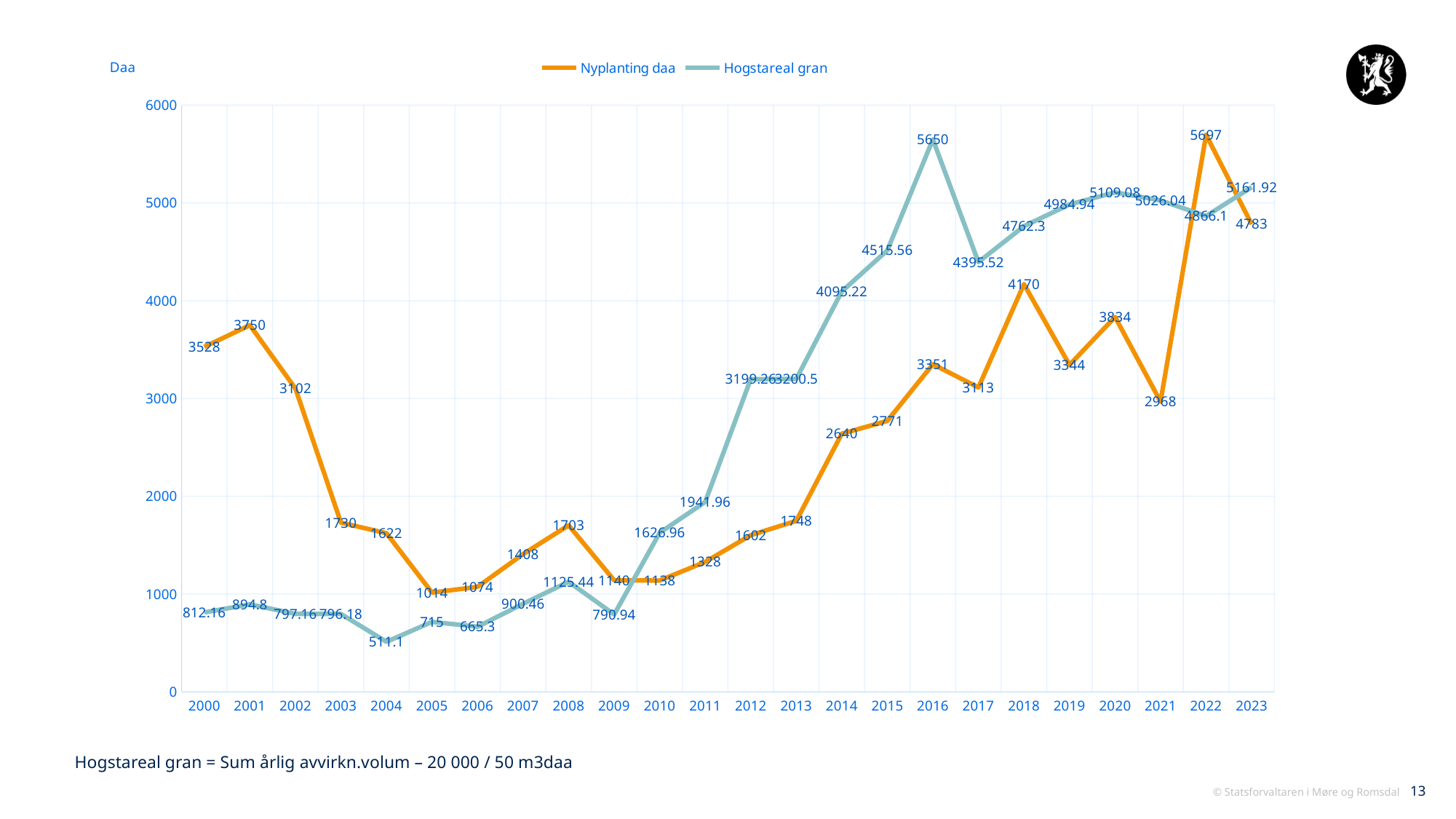
What is the value of Hogstareal gran in 2004? 511.1 What is the difference between Nyplanting daa in 2022 and in 2023? 914 In 2018, which series has the larger value, Nyplanting daa or Hogstareal gran? Hogstareal gran In which year is Nyplanting daa highest? 2022 How many series does the legend list? 2 What is the value of Hogstareal gran in 2016? 5650 How many years are shown on the x axis? 24 Does Nyplanting daa rise or fall from 2001 to 2005? Fall In which year is Hogstareal gran lowest? 2004 What kind of chart is shown on the slide? Line chart In which year is Nyplanting daa lowest? 2005 What is the value of Nyplanting daa in 2022? 5697